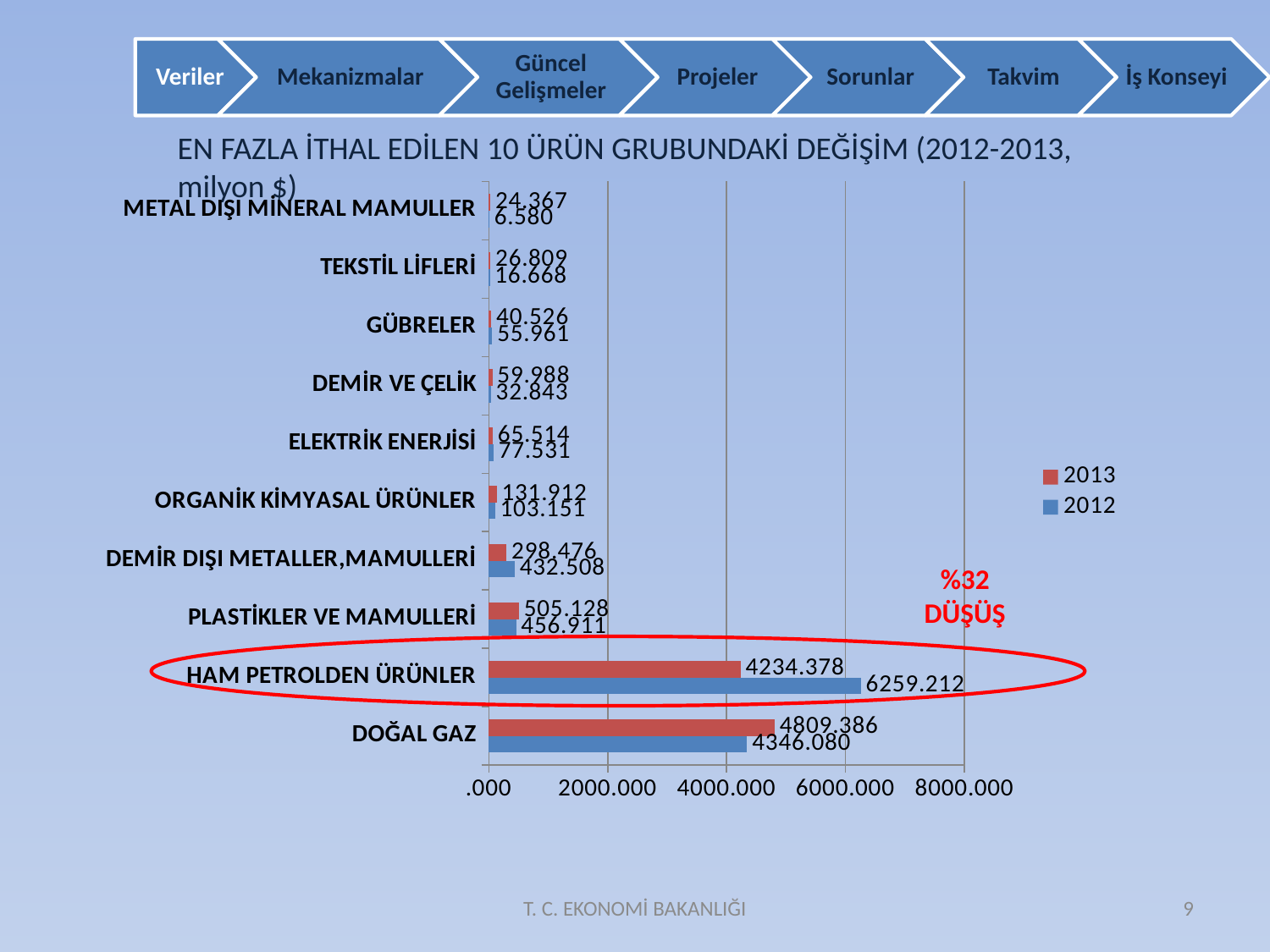
What is the 2012 value for PLASTİKLER VE MAMULLERİ? 456.911 What is the 2013 value for HAM PETROLDEN ÜRÜNLER? 4234.378 How many series does the legend list? 2 For DOĞAL GAZ, which is larger: the 2013 value or the 2012 value? 2013 What type of chart is shown on the slide? bar chart What is the difference between the 2012 and 2013 values for HAM PETROLDEN ÜRÜNLER? 2024.834 What is the 2013 value for DOĞAL GAZ? 4809.386 How many product groups (categories) are shown in the chart? 10 What is the 2012 value for HAM PETROLDEN ÜRÜNLER? 6259.212 Which product group has the highest 2013 value? DOĞAL GAZ Which colour represents the 2013 series in the chart? red Which product group has the highest 2012 value? HAM PETROLDEN ÜRÜNLER